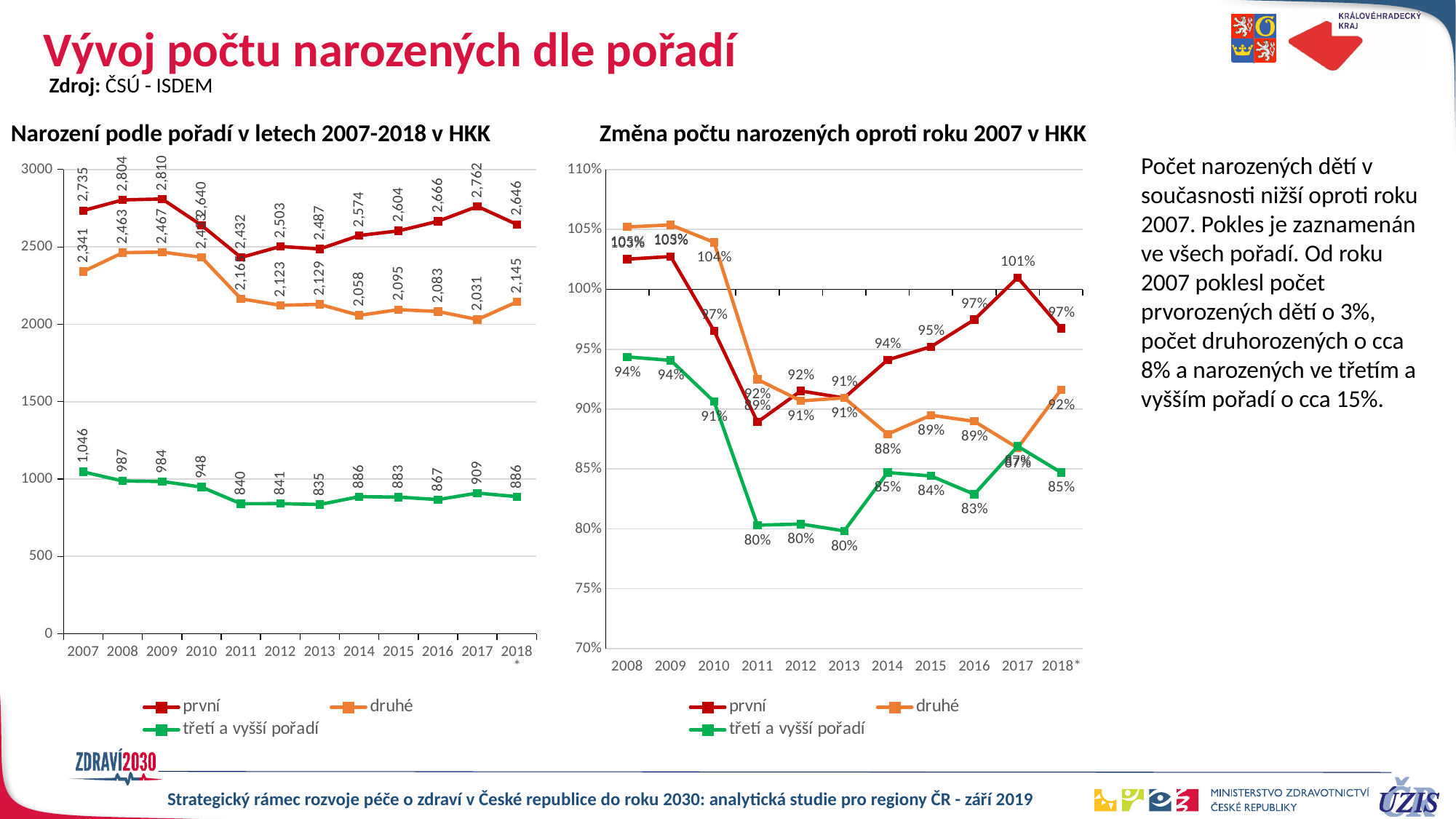
In the chart 'Změna počtu narozených oproti roku 2007 v HKK', how many years are shown on the x axis? 11 In the chart 'Narození podle pořadí v letech 2007-2018 v HKK', how many series does the legend list? 3 In the chart 'Narození podle pořadí v letech 2007-2018 v HKK', what is the value for 'druhé' in 2017? 2,031 In the chart 'Narození podle pořadí v letech 2007-2018 v HKK', what is the value for 'třetí a vyšší pořadí' in 2007? 1,046 What kind of chart is 'Změna počtu narozených oproti roku 2007 v HKK'? line chart In the chart 'Změna počtu narozených oproti roku 2007 v HKK', which is larger in 2014: 'první' or 'druhé'? první In the chart 'Narození podle pořadí v letech 2007-2018 v HKK', in which year is the 'třetí a vyšší pořadí' series lowest? 2013 In the chart 'Narození podle pořadí v letech 2007-2018 v HKK', in which year is the 'první' series highest? 2009 In the chart 'Narození podle pořadí v letech 2007-2018 v HKK', what is the difference between the 'první' values in 2017 and 2018? 116 In the chart 'Narození podle pořadí v letech 2007-2018 v HKK', what is the value for 'první' in 2009? 2,810 In the chart 'Změna počtu narozených oproti roku 2007 v HKK', what is the value for 'třetí a vyšší pořadí' in 2016? 83% In the chart 'Změna počtu narozených oproti roku 2007 v HKK', what is the value for 'první' in 2017? 101%